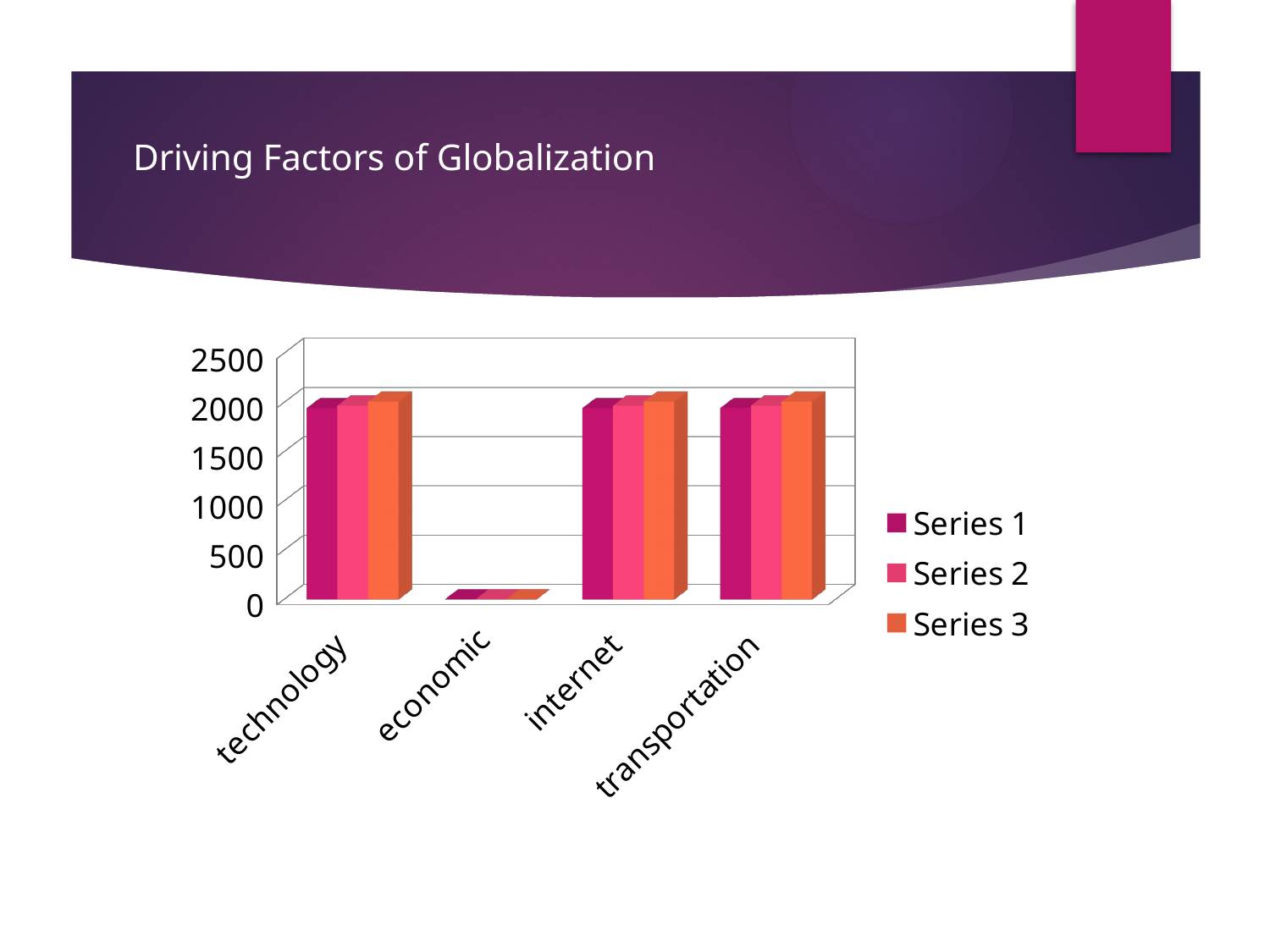
What are the entries listed in the chart's legend? Series 1, Series 2, Series 3 What kind of chart is shown on the slide? bar chart Which category has the lowest value for Series 3? economic Is the value for transportation in Series 2 greater or less than 1000? greater How many categories are shown on the x axis of the chart? 4 Which category has the lowest value for Series 1? economic How many series does the chart's legend list? 3 Is the value for internet in Series 1 greater or less than 2500? less Which is larger for Series 3: the value for internet or the value for economic? internet Is the value for technology in Series 1 greater or less than 1500? greater Which is larger for Series 1: the value for technology or the value for economic? technology